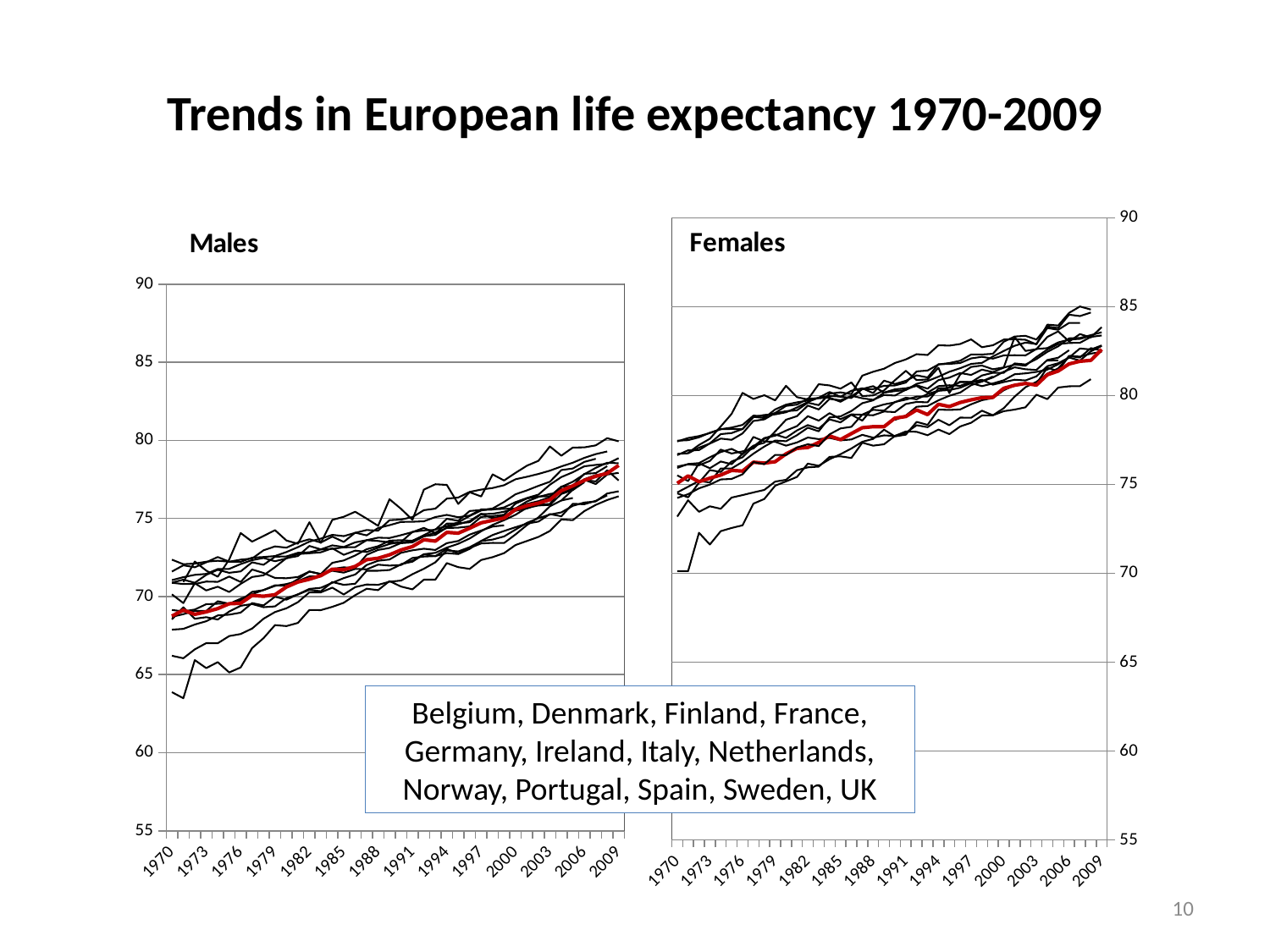
In the Males chart, is the value of the red line in 2009 greater or less than 80? less In the Females chart, do the lines generally rise or fall from 1970 to 2009? rise In the Females chart, is the value of the red line in 1970 greater or less than 80? less In the Males chart, is the value of the red line in 1970 greater or less than 75? less What kind of chart is the Males chart? line chart How many countries are listed in the text box on the slide? 13 What kind of chart is the Females chart? line chart What colour is the highlighted line in each chart? red In the Males chart, do the lines generally rise or fall from 1970 to 2009? rise What is the title of the slide? Trends in European life expectancy 1970-2009